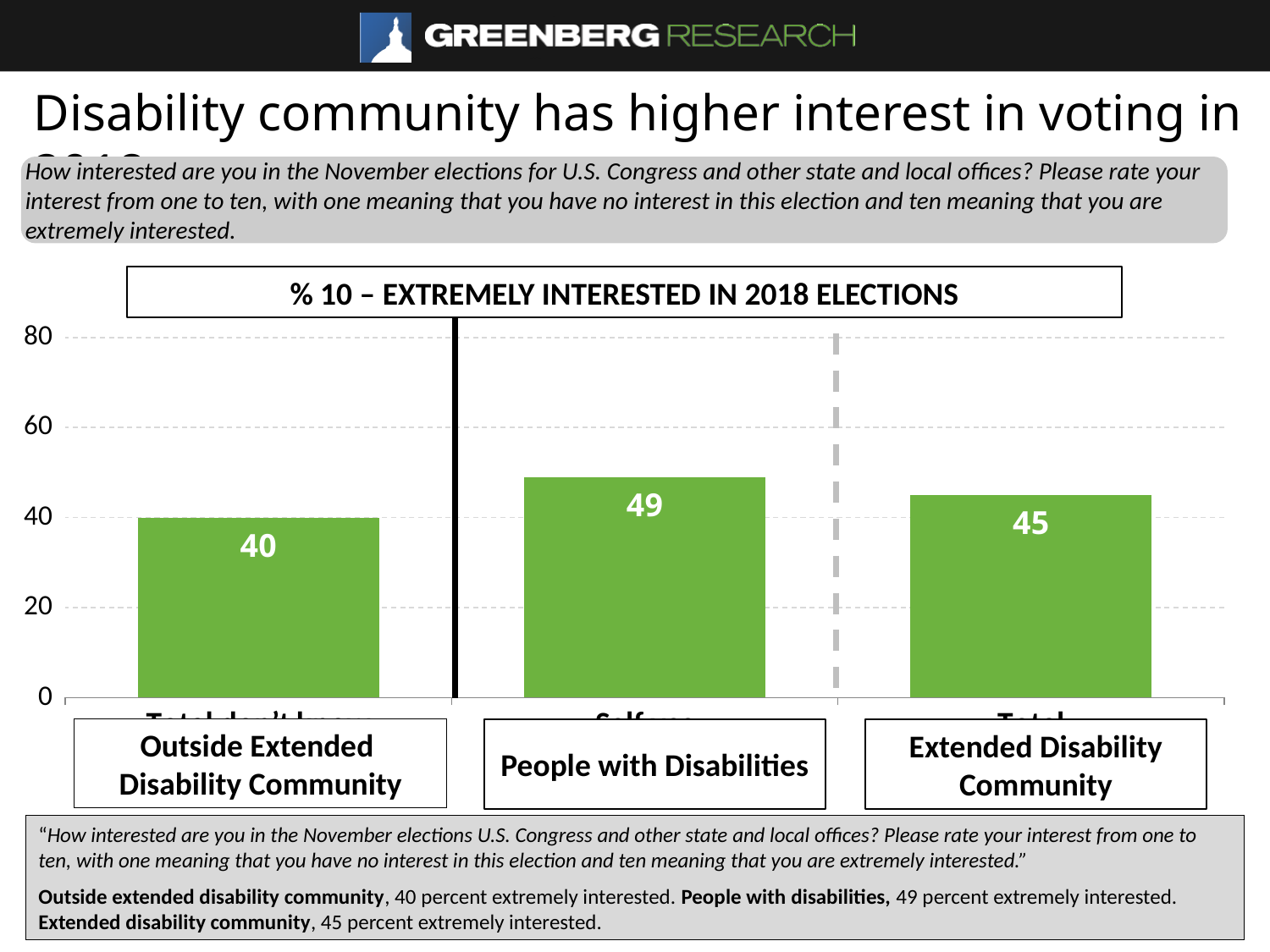
What is the difference between the values for Extended Disability Community and Outside Extended Disability Community? 5 What kind of chart is shown on the slide? bar chart How many categories are shown in the chart? 3 Which is larger, the value for Extended Disability Community or the value for People with Disabilities? People with Disabilities What is the difference between the values for People with Disabilities and Outside Extended Disability Community? 9 What is the value for Outside Extended Disability Community? 40 Which category has the lowest value? Outside Extended Disability Community What is the title of the chart? % 10 – EXTREMELY INTERESTED IN 2018 ELECTIONS What is the value for People with Disabilities? 49 What is the value for Extended Disability Community? 45 Which category has the highest value? People with Disabilities Is the value for People with Disabilities greater or less than 60? less